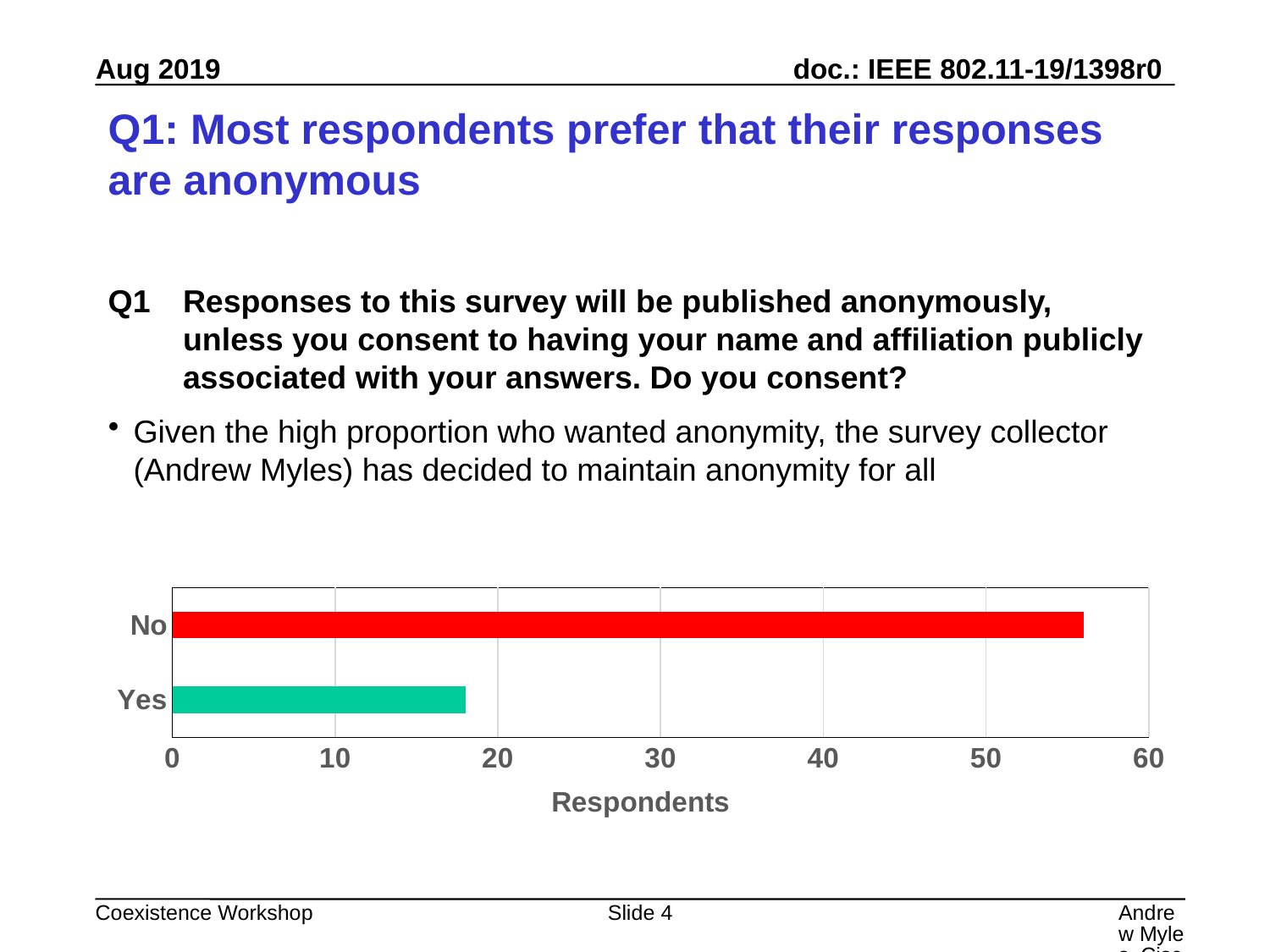
Is the value for No greater or less than 60? less Which has more respondents, Yes or No? No Is the value for Yes greater or less than 20? less Is the value for Yes greater or less than 10? greater What colour is the bar for No? red How many categories does the chart show? 2 What is the label of the horizontal axis? Respondents Which category has the lowest number of respondents? Yes Which category has the highest number of respondents? No What kind of chart is shown on the slide? bar chart